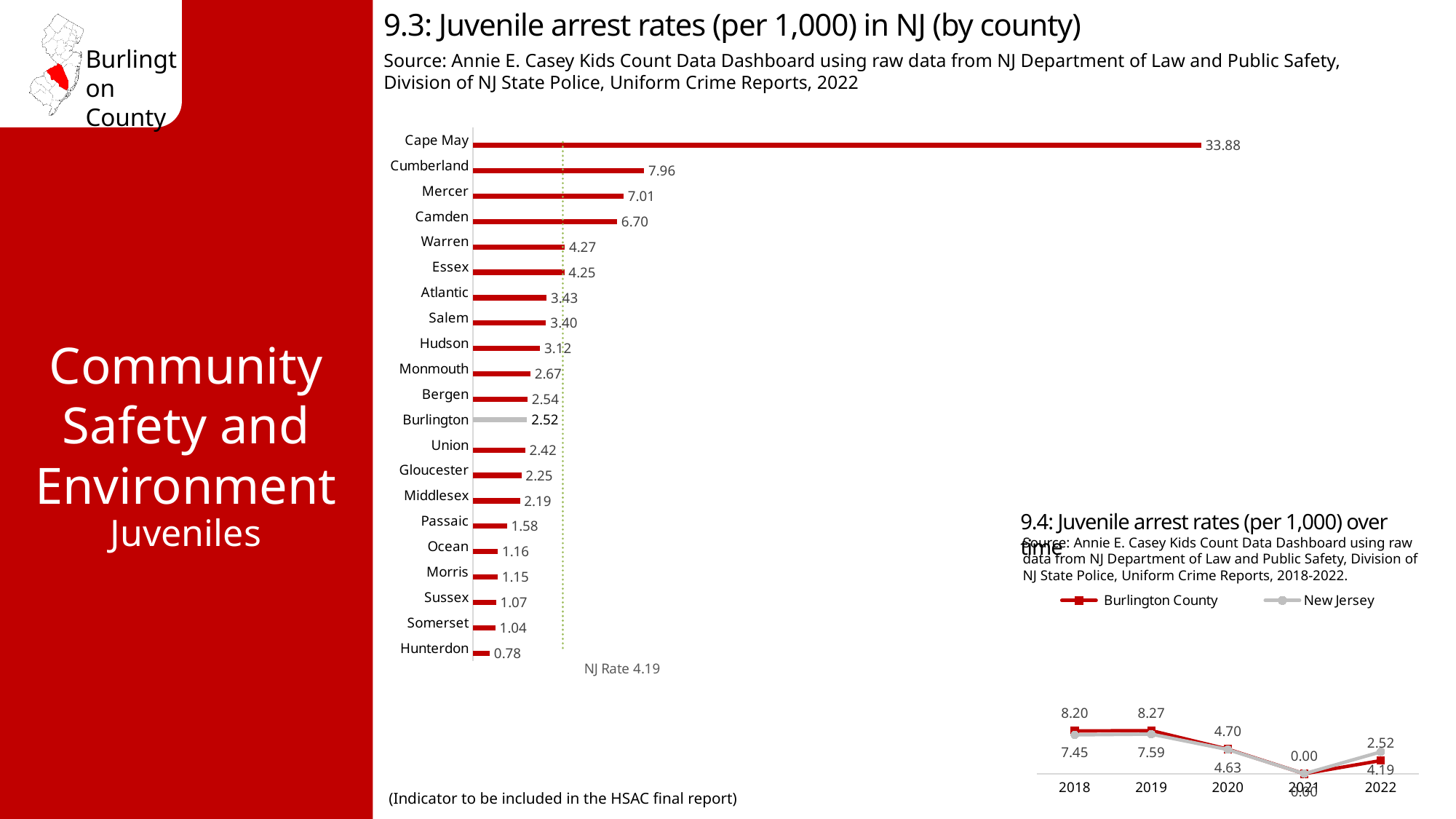
In the chart '9.3: Juvenile arrest rates (per 1,000) in NJ (by county)', what is the difference between the values for Cumberland and Mercer? 0.95 How many series does the legend list in the chart '9.4: Juvenile arrest rates (per 1,000) over time'? 2 In the chart '9.4: Juvenile arrest rates (per 1,000) over time', what is the value for Burlington County in 2019? 8.27 How many counties are shown in the chart '9.3: Juvenile arrest rates (per 1,000) in NJ (by county)'? 21 What kind of chart is '9.3: Juvenile arrest rates (per 1,000) in NJ (by county)'? Bar chart In the chart '9.3: Juvenile arrest rates (per 1,000) in NJ (by county)', which is larger, the value for Camden or the value for Warren? Camden In the chart '9.4: Juvenile arrest rates (per 1,000) over time', what is the difference between the Burlington County values for 2018 and 2020? 3.50 In the chart '9.3: Juvenile arrest rates (per 1,000) in NJ (by county)', what NJ rate is marked by the dotted reference line? 4.19 In the chart '9.3: Juvenile arrest rates (per 1,000) in NJ (by county)', what is the value for Burlington? 2.52 In the chart '9.3: Juvenile arrest rates (per 1,000) in NJ (by county)', which county has the lowest rate? Hunterdon In the chart '9.3: Juvenile arrest rates (per 1,000) in NJ (by county)', which county has the highest rate? Cape May In the chart '9.4: Juvenile arrest rates (per 1,000) over time', what is the value for New Jersey in 2022? 4.19